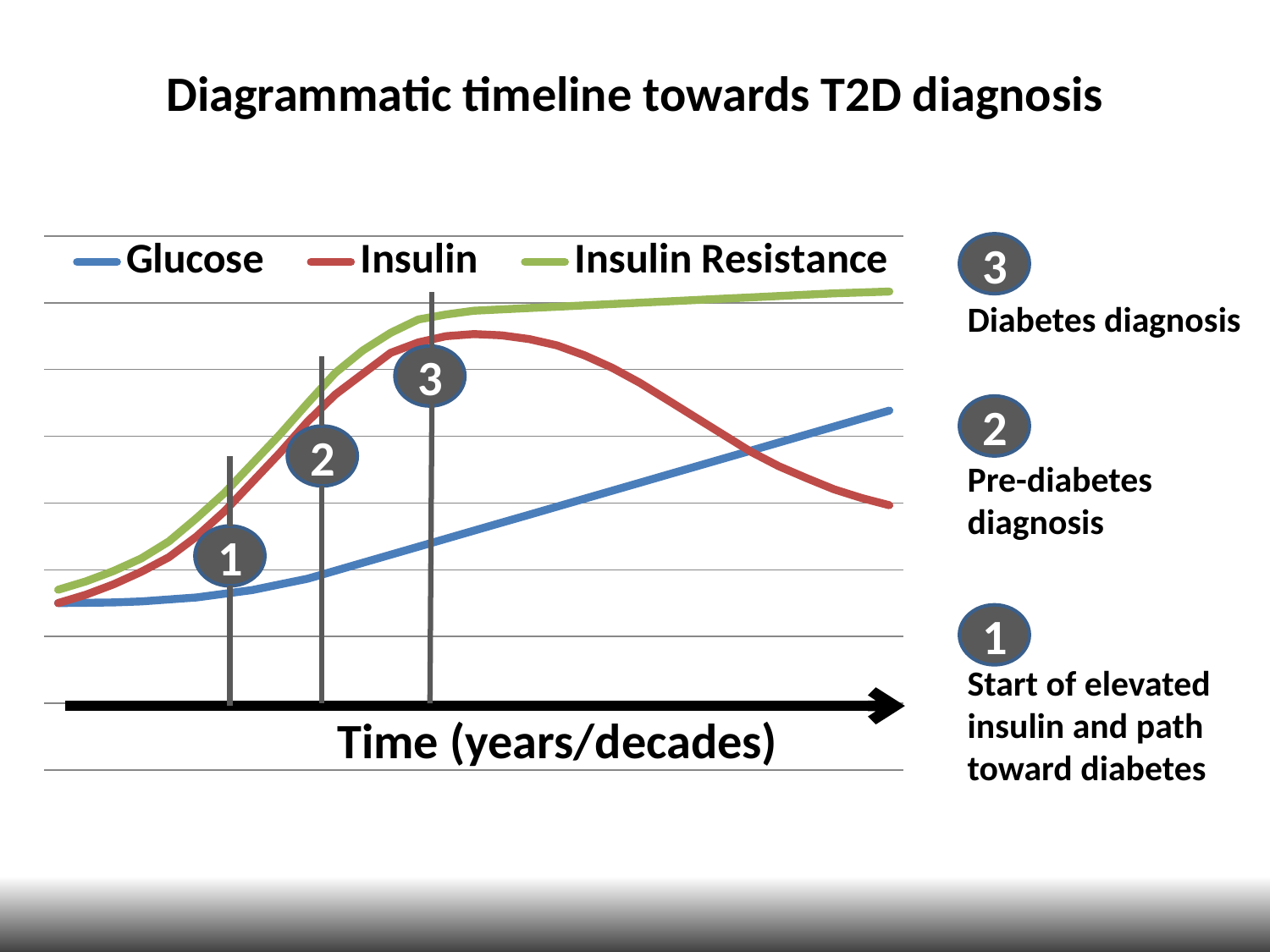
What are the three series named in the chart's legend? Glucose, Insulin, Insulin Resistance Does the Insulin Resistance line rise or fall as time increases along the x axis? Rises How does the Insulin line change as time increases along the x axis? Rises then falls How many series does the chart's legend list? 3 What is the label on the chart's horizontal axis? Time (years/decades) At the right end of the chart, which series is lowest? Insulin Does the Glucose line rise or fall as time increases along the x axis? Rises What kind of chart is shown on the slide? Line chart At marker 3, which is higher, the Insulin Resistance line or the Glucose line? Insulin Resistance At the right end of the chart, which is higher, the Glucose line or the Insulin line? Glucose At the right end of the chart, which series is highest? Insulin Resistance How many numbered markers are placed on the chart's timeline? 3